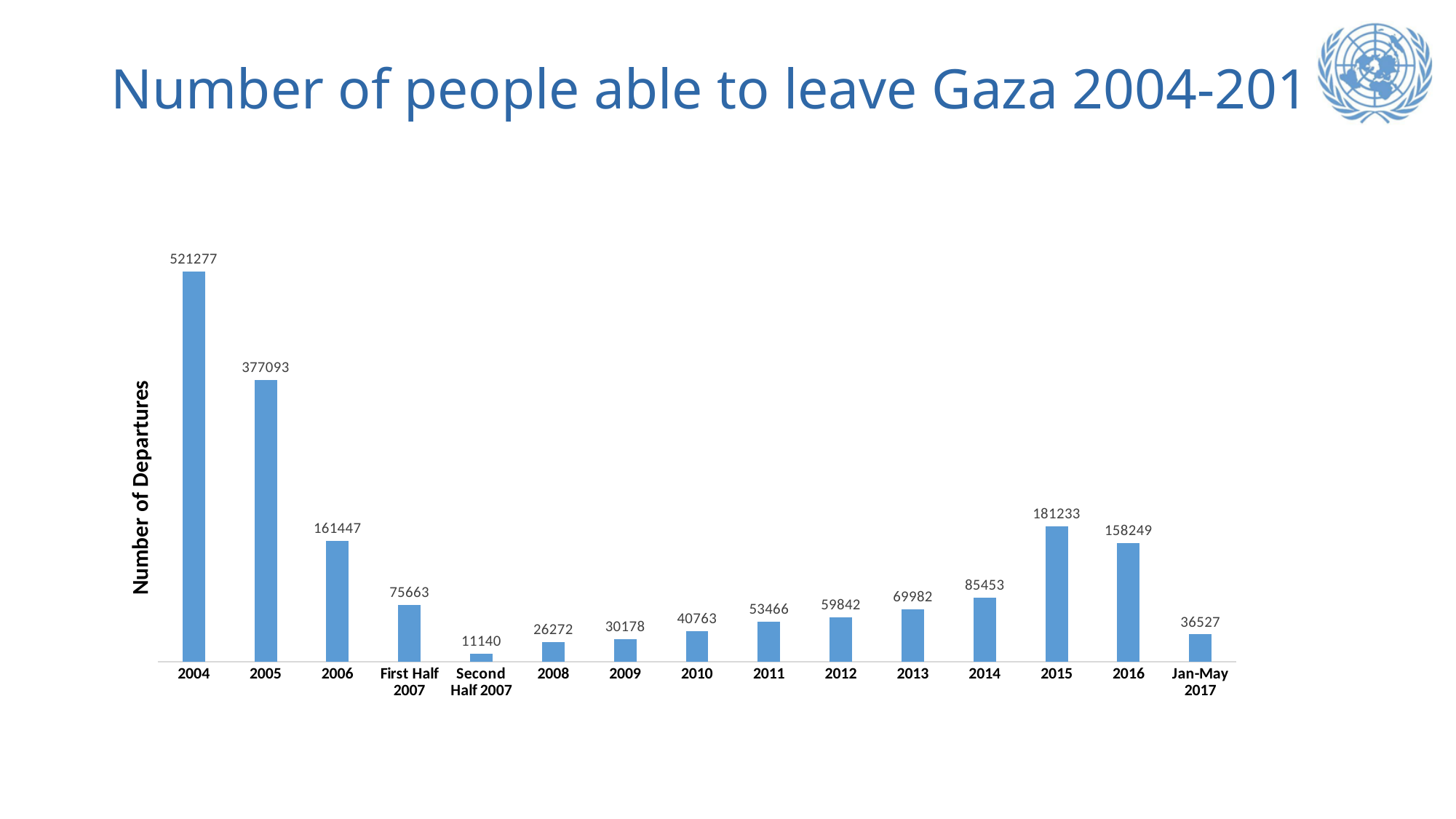
What is the number of departures for 2004? 521277 What kind of chart is shown on the slide? Bar chart What is the difference in departures between 2004 and 2005? 144184 What is the number of departures for Jan-May 2017? 36527 Do the values rise or fall from Second Half 2007 through 2015? Rise What is the number of departures for 2015? 181233 What is the difference in departures between 2015 and 2016? 22984 Which category has the highest number of departures? 2004 How many categories are shown on the x axis? 15 Which has more departures, 2013 or 2014? 2014 Which category has the lowest number of departures? Second Half 2007 What is the number of departures for Second Half 2007? 11140